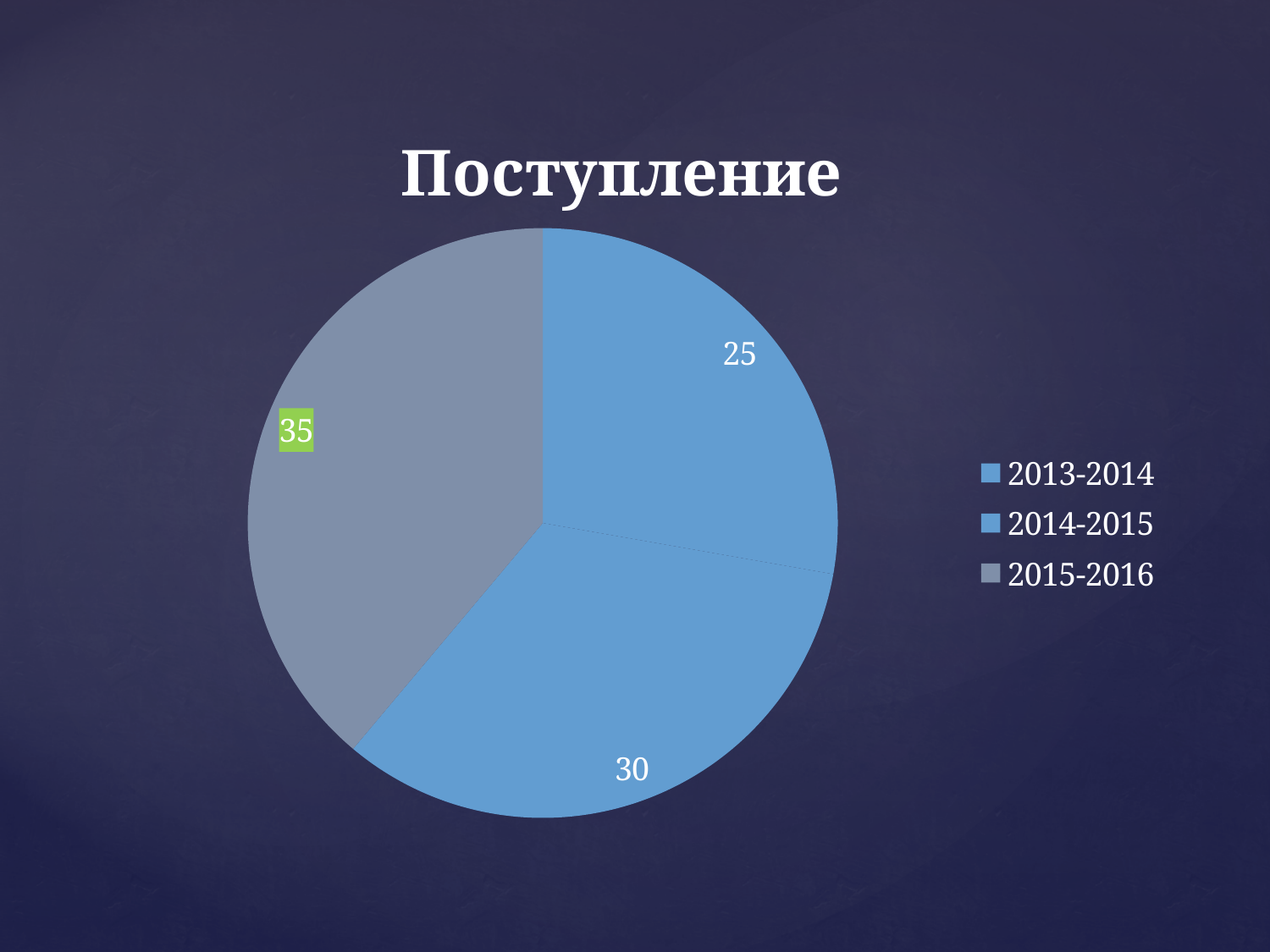
What is the difference between the values for 2015-2016 and 2013-2014? 10 What is the difference between the values for 2014-2015 and 2013-2014? 5 What is the value for 2015-2016? 35 How many entries does the legend list? 3 What is the title of the chart? Поступление Which is larger, the value for 2014-2015 or the value for 2015-2016? 2015-2016 Which period has the smallest slice? 2013-2014 How many slices does the pie chart have? 3 What is the value for 2013-2014? 25 What type of chart is shown on the slide? pie chart What is the value for 2014-2015? 30 Which period has the largest slice? 2015-2016